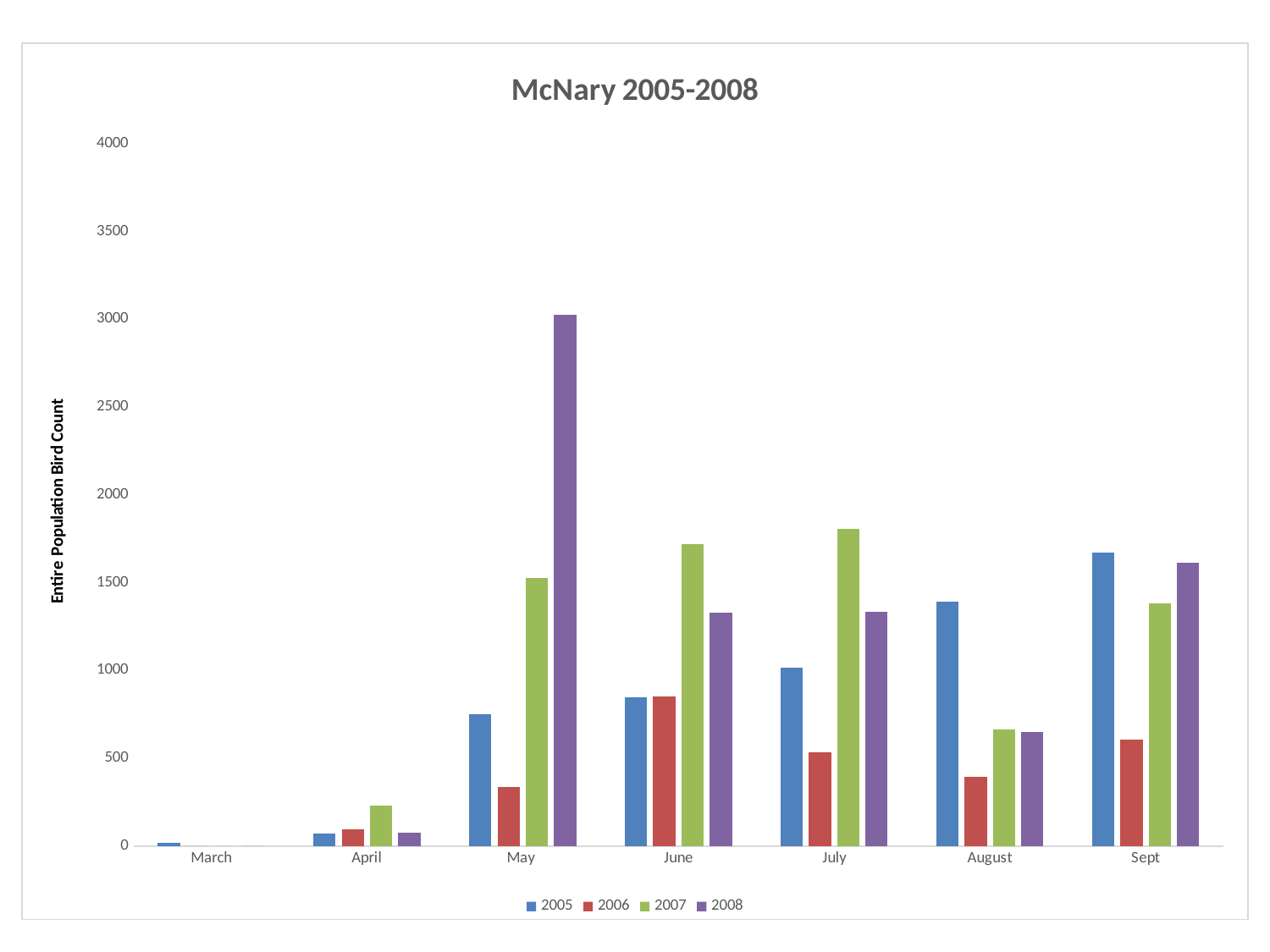
How many series does the legend list? 4 What kind of chart is shown on the slide? bar chart In August, which year has the lowest bar? 2006 In which month is the 2008 bar the highest? May Is the value for 2007 in July greater or less than 1500? greater Is the value for 2006 in May greater or less than 500? less Does the 2005 series generally rise or fall from March to Sept? rise How many months are shown on the x axis? 7 In August, which is larger: the value for 2005 or the value for 2007? 2005 Is the value for 2008 in May greater or less than 2500? greater What is the label on the vertical axis? Entire Population Bird Count What is the title of the chart? McNary 2005-2008